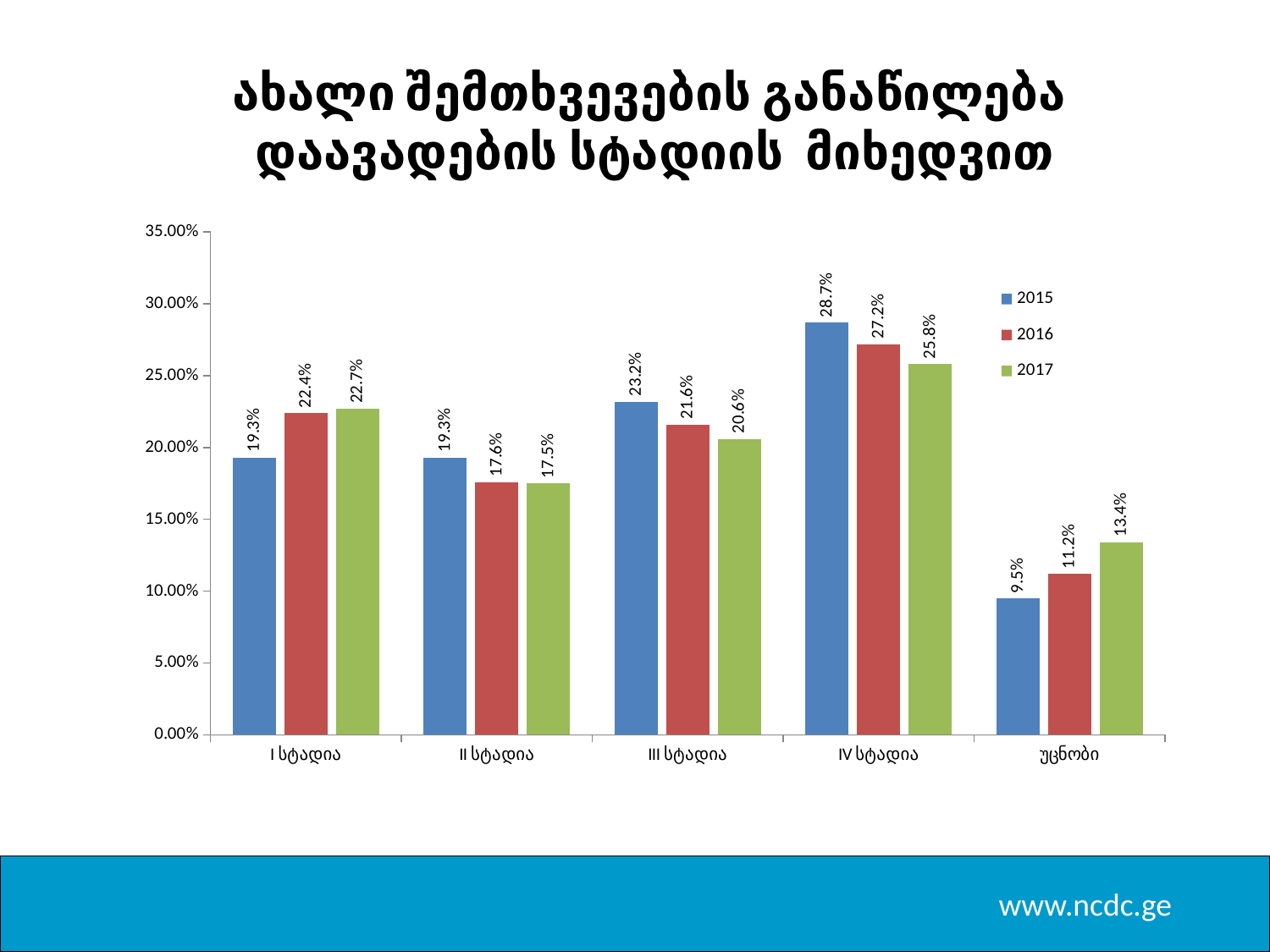
What is the value for 2015 in the IV სტადია category? 28.7% How many series does the legend list? 3 What is the value for 2017 in the უცნობი category? 13.4% Do the values for the უცნობი category rise or fall from 2015 to 2017? rise What is the difference between the 2015 and 2017 values in the IV სტადია category? 2.9% Which is larger in the I სტადია category, the 2015 value or the 2016 value? 2016 How many categories are shown on the x axis? 5 Which category has the lowest value for the 2015 series? უცნობი Which series is shown in green in the legend? 2017 What type of chart is shown on the slide? bar chart Which category has the highest value for the 2017 series? IV სტადია What is the value for 2016 in the II სტადია category? 17.6%